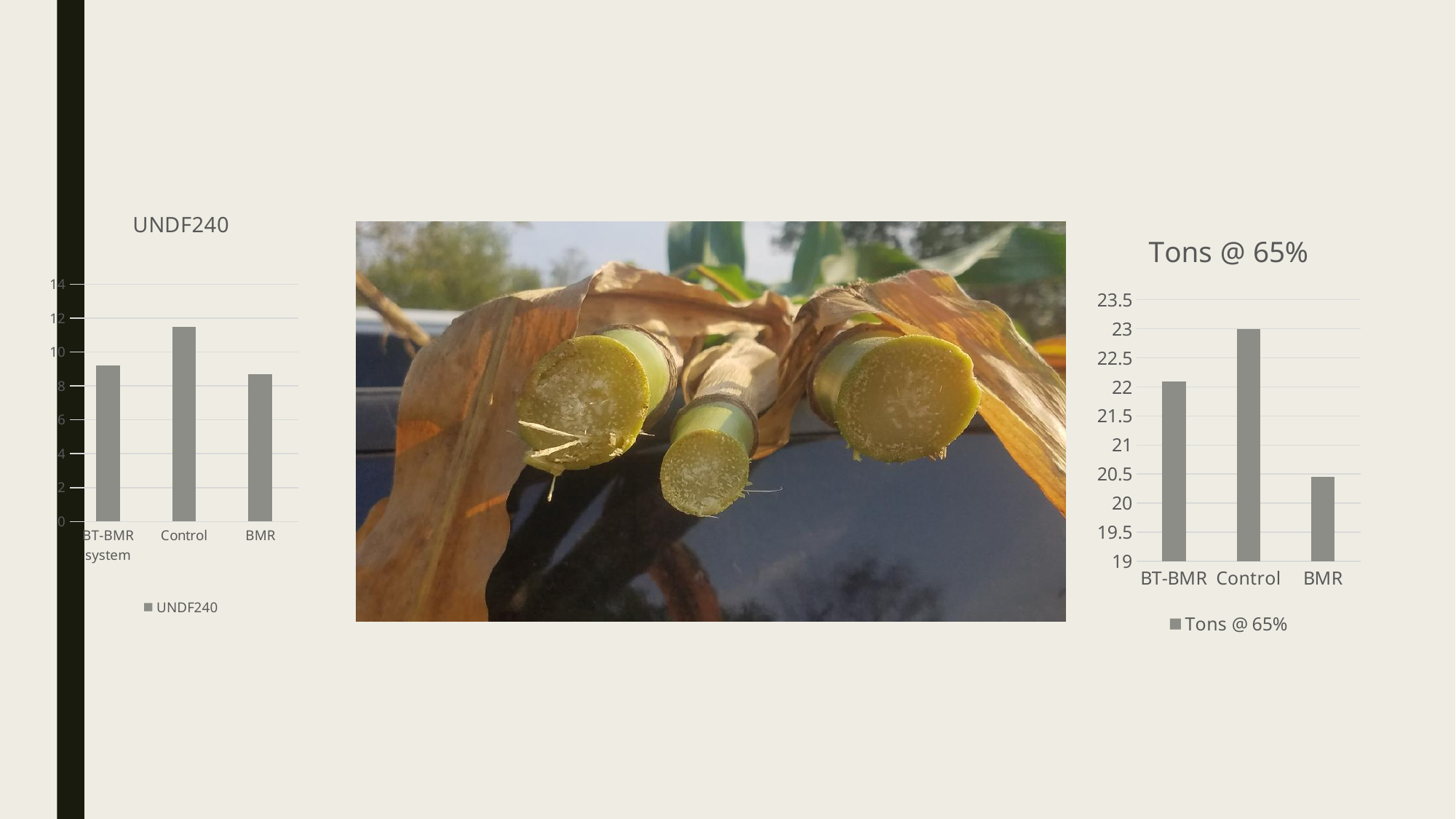
In the Tons @ 65% chart, which is larger, BT-BMR or BMR? BT-BMR How many series does the legend of the Tons @ 65% chart list? 1 In the UNDF240 chart, which is larger, Control or BMR? Control How many categories are shown in the UNDF240 chart? 3 In the UNDF240 chart, is the value for BMR greater or less than 10? less In the UNDF240 chart, which category has the highest value? Control In the Tons @ 65% chart, which category has the lowest value? BMR In the UNDF240 chart, is the value for Control greater or less than 10? greater What kind of chart is the UNDF240 chart? bar chart In the Tons @ 65% chart, is the value for BMR greater or less than 21? less In the Tons @ 65% chart, which category has the highest value? Control